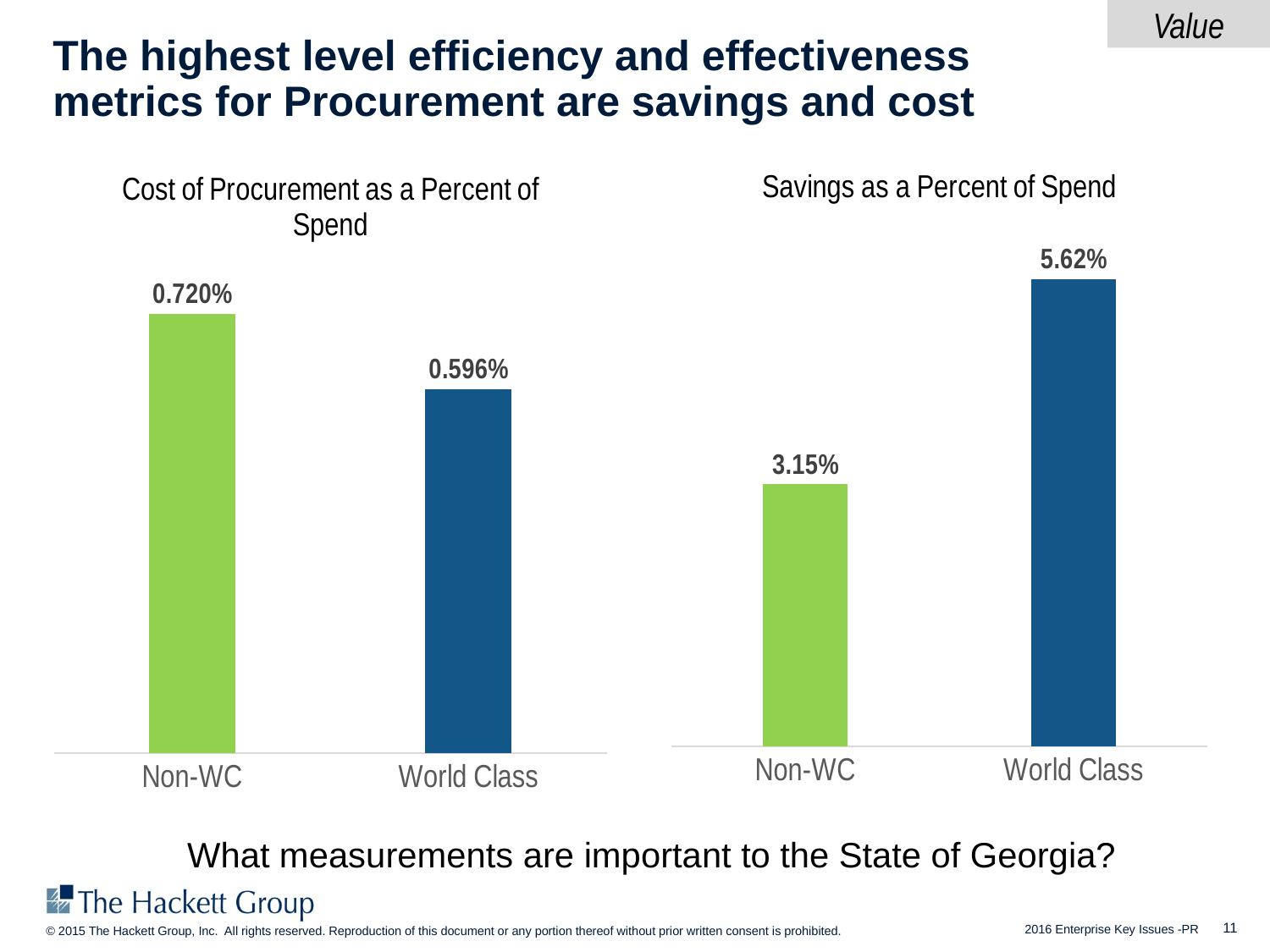
In the 'Savings as a Percent of Spend' chart, which is larger, Non-WC or World Class? World Class In the 'Savings as a Percent of Spend' chart, what is the value for World Class? 5.62% What is the title of the chart on the left side of the slide? Cost of Procurement as a Percent of Spend In the 'Savings as a Percent of Spend' chart, which category has the lowest value? Non-WC In the 'Cost of Procurement as a Percent of Spend' chart, what is the value for World Class? 0.596% In the 'Cost of Procurement as a Percent of Spend' chart, what is the difference between the Non-WC and World Class values? 0.124% What type of chart is the 'Savings as a Percent of Spend' chart? Bar chart In the 'Cost of Procurement as a Percent of Spend' chart, which category has the highest value? Non-WC In the 'Savings as a Percent of Spend' chart, what is the difference between the World Class and Non-WC values? 2.47% In the 'Cost of Procurement as a Percent of Spend' chart, what is the value for Non-WC? 0.720% In the 'Savings as a Percent of Spend' chart, what is the value for Non-WC? 3.15% How many categories are shown in the 'Cost of Procurement as a Percent of Spend' chart? 2